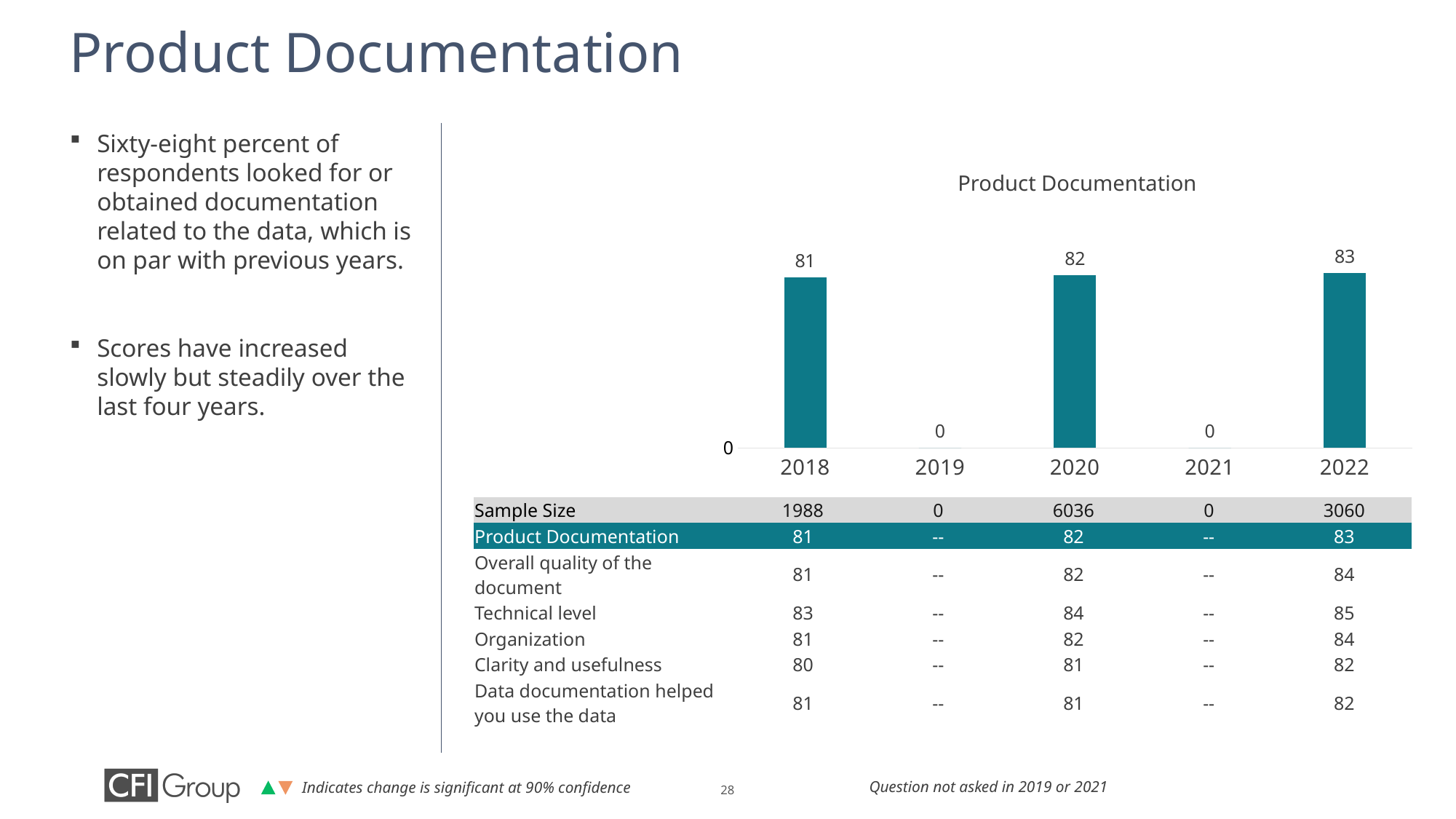
What is the Product Documentation score for 2018? 81 Among the years with a non-zero bar, which year has the lowest Product Documentation score? 2018 How many years are shown on the x axis of the chart? 5 What is the difference between the Product Documentation scores for 2022 and 2018? 2 Is the Product Documentation score for 2020 higher or lower than for 2018? higher Which year has the highest Product Documentation score in the chart? 2022 What is the title of the chart? Product Documentation What is the Product Documentation score for 2022? 83 What is the Product Documentation score for 2020? 82 What value is shown for 2019 in the chart? 0 What type of chart is shown on the slide? bar chart Do the Product Documentation scores rise or fall from 2018 to 2022 across the years with data? rise